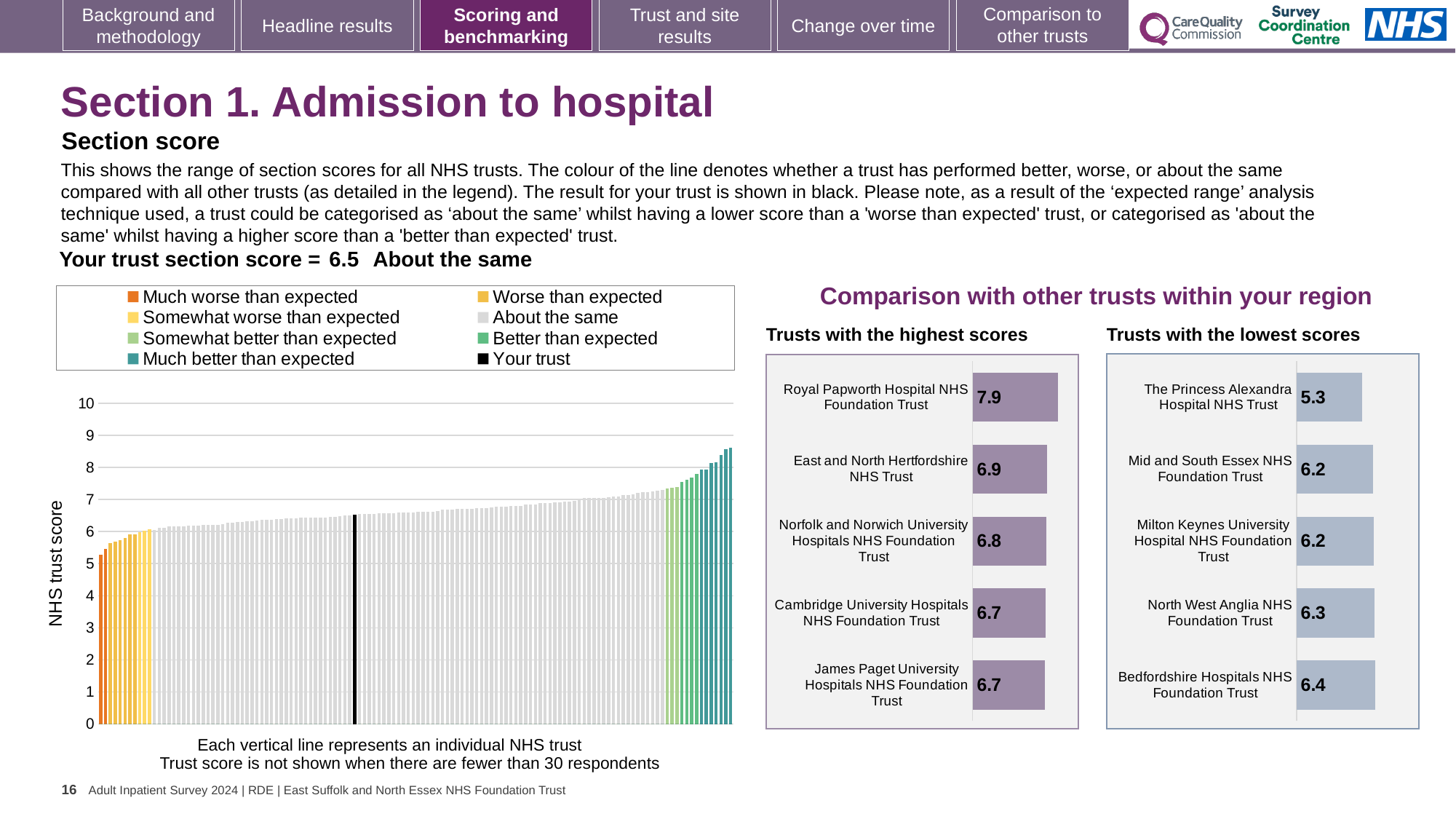
What kind of chart is the NHS trust score chart on the left of the slide? Bar chart In the 'Trusts with the highest scores' chart, which trust has the highest score? Royal Papworth Hospital NHS Foundation Trust In the 'Trusts with the lowest scores' chart, what is the score for The Princess Alexandra Hospital NHS Trust? 5.3 How many trusts are shown in the 'Trusts with the highest scores' chart? 5 In the 'Trusts with the highest scores' chart, what is the score for Royal Papworth Hospital NHS Foundation Trust? 7.9 In the 'Trusts with the highest scores' chart, what is the difference between the scores of Royal Papworth Hospital NHS Foundation Trust and East and North Hertfordshire NHS Trust? 1.0 In the NHS trust score chart on the left, what colour represents 'Your trust'? Black In the 'Trusts with the lowest scores' chart, which trust has the lowest score? The Princess Alexandra Hospital NHS Trust In the NHS trust score chart on the left, do the values rise or fall from left to right? Rise How many trusts are shown in the 'Trusts with the lowest scores' chart? 5 How many entries does the legend of the NHS trust score chart on the left list? 8 In the 'Trusts with the lowest scores' chart, which has the larger score: Bedfordshire Hospitals NHS Foundation Trust or North West Anglia NHS Foundation Trust? Bedfordshire Hospitals NHS Foundation Trust